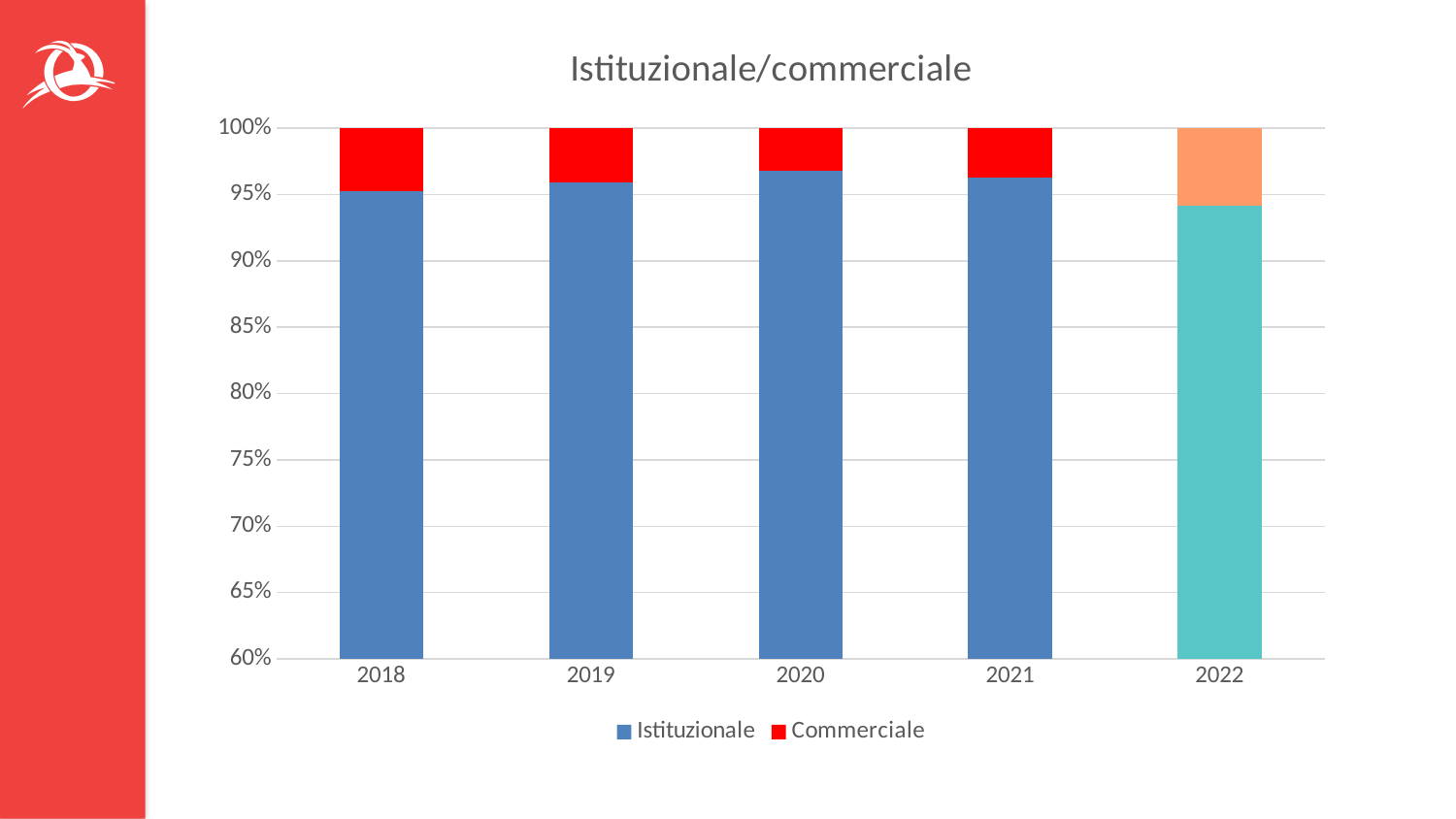
Which year has the larger Istituzionale share, 2018 or 2019? 2019 How many years are shown on the x axis? 5 In which year is the Commerciale share the largest? 2022 Is the Istituzionale value for 2022 greater or less than 95%? less Which series is shown in red in the legend? Commerciale What is the total of the stacked bar for 2018? 100% Is the Istituzionale value for 2020 greater or less than 90%? greater Is the Istituzionale value for 2019 greater or less than 95%? greater What is the title of the chart? Istituzionale/commerciale In which year is the Istituzionale share the lowest? 2022 How many series does the legend list? 2 What kind of chart is shown on the slide? Stacked bar chart